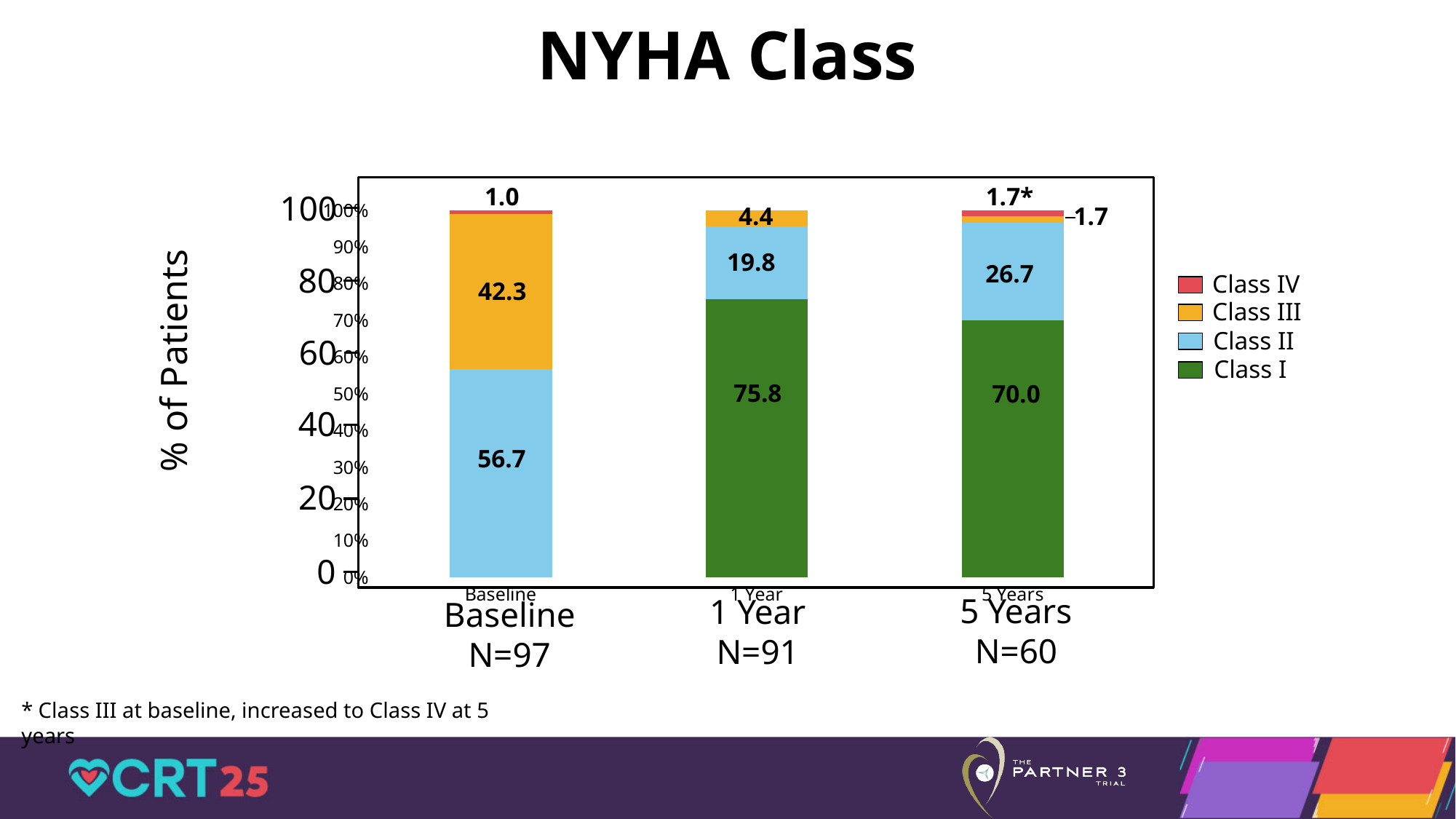
What is the Class III value at 1 Year? 4.4 At which time point is the Class I share highest? 1 Year What is the title of the chart? NYHA Class What kind of chart is shown on the slide? Stacked bar chart What is the difference between the Class I value at 1 Year and at 5 Years? 5.8 Which is larger, the Class II value at 1 Year or at 5 Years? 5 Years How many time points are shown on the x axis? 3 What is the Class II value at Baseline? 56.7 How many series does the legend list? 4 What is the Class III value at Baseline? 42.3 What is the Class II value at 5 Years? 26.7 What is the Class I value at 1 Year? 75.8